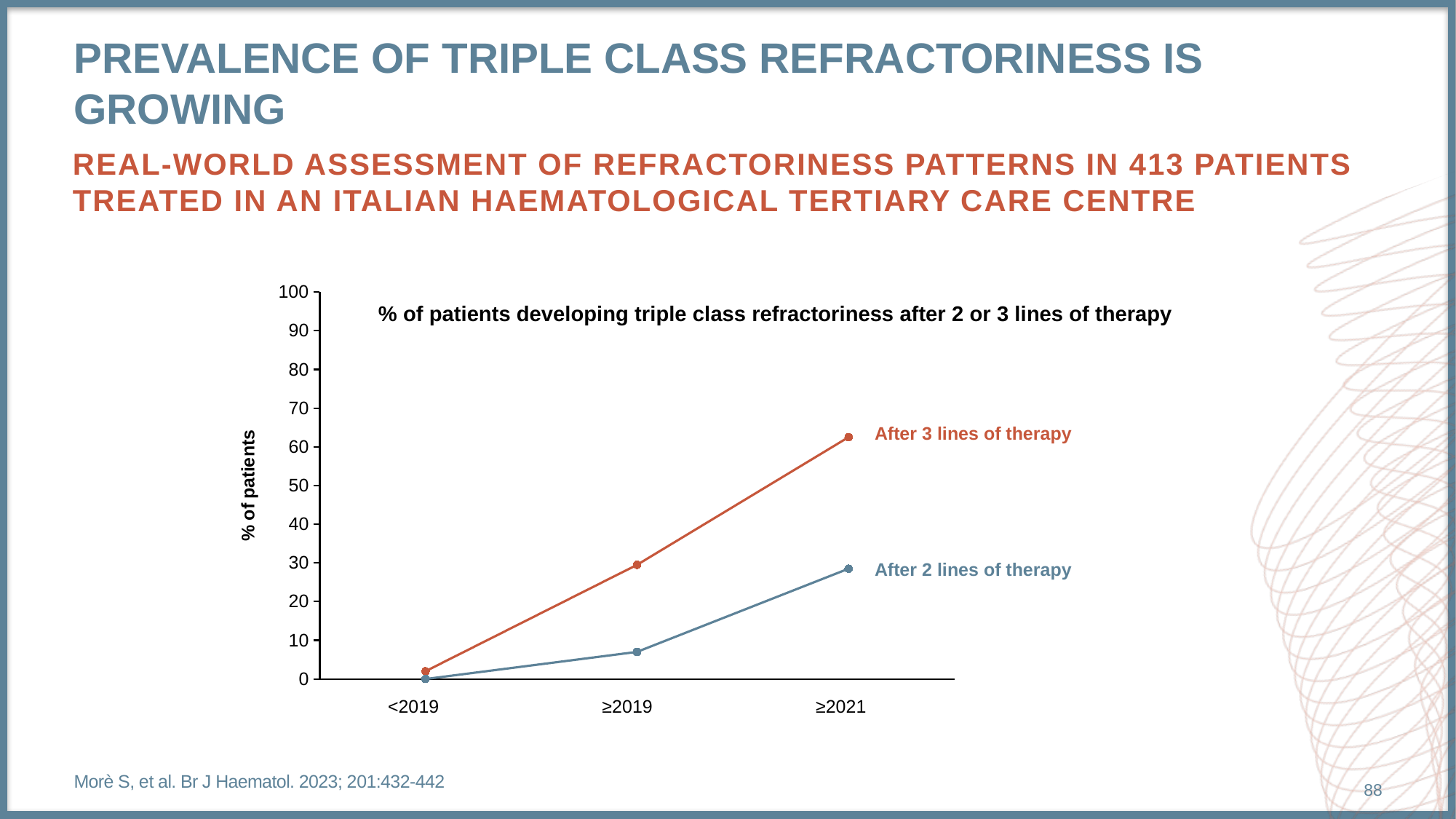
What is the label of the y axis? % of patients Is the value for 'After 2 lines of therapy' at ≥2019 greater or less than 10? less How many time-period categories are shown on the x axis? 3 In which period is the value for 'After 2 lines of therapy' lowest? <2019 Do the values for 'After 3 lines of therapy' rise or fall from <2019 to ≥2021? Rise How many series are plotted on the chart? 2 Is the value for 'After 3 lines of therapy' at ≥2021 greater or less than 50? greater Do the values for 'After 2 lines of therapy' rise or fall across the x axis? Rise At ≥2021, which series has the larger value: 'After 3 lines of therapy' or 'After 2 lines of therapy'? After 3 lines of therapy What kind of chart is shown on the slide? Line chart In which period is the value for 'After 3 lines of therapy' highest? ≥2021 What is the title of the chart? % of patients developing triple class refractoriness after 2 or 3 lines of therapy